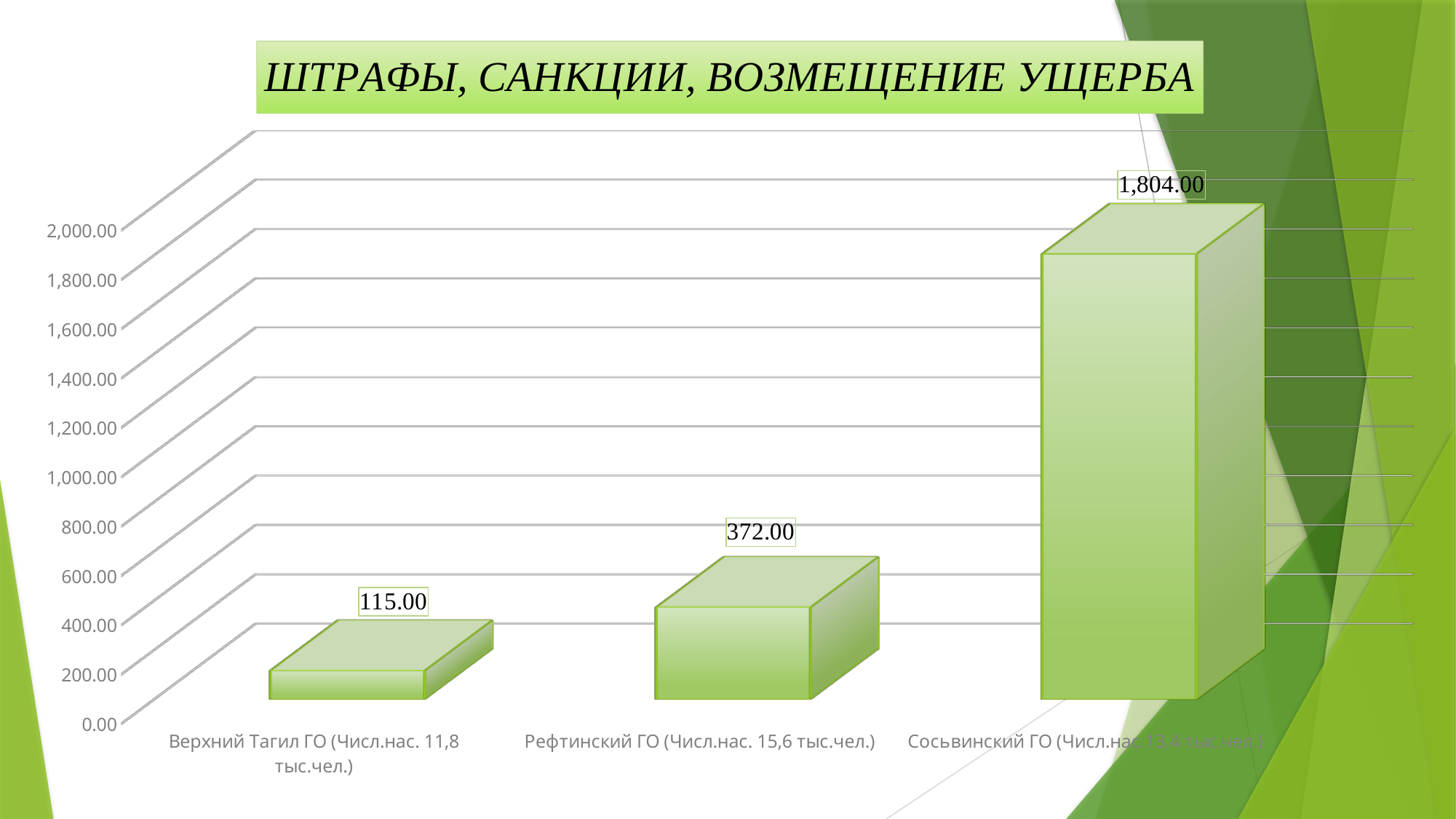
What is the difference between the values for Рефтинский ГО and Верхний Тагил ГО? 257.00 What is the value for Сосьвинский ГО? 1,804.00 What is the title of the chart? ШТРАФЫ, САНКЦИИ, ВОЗМЕЩЕНИЕ УЩЕРБА How many categories are shown in the chart? 3 What kind of chart is shown on the slide? Bar chart Which is larger, the value for Рефтинский ГО or the value for Верхний Тагил ГО? Рефтинский ГО What is the value for Верхний Тагил ГО? 115.00 What is the value for Рефтинский ГО? 372.00 Is the value for Сосьвинский ГО greater or less than 1,600.00? greater What is the difference between the values for Сосьвинский ГО and Рефтинский ГО? 1,432.00 Which category has the highest value? Сосьвинский ГО Which category has the lowest value? Верхний Тагил ГО